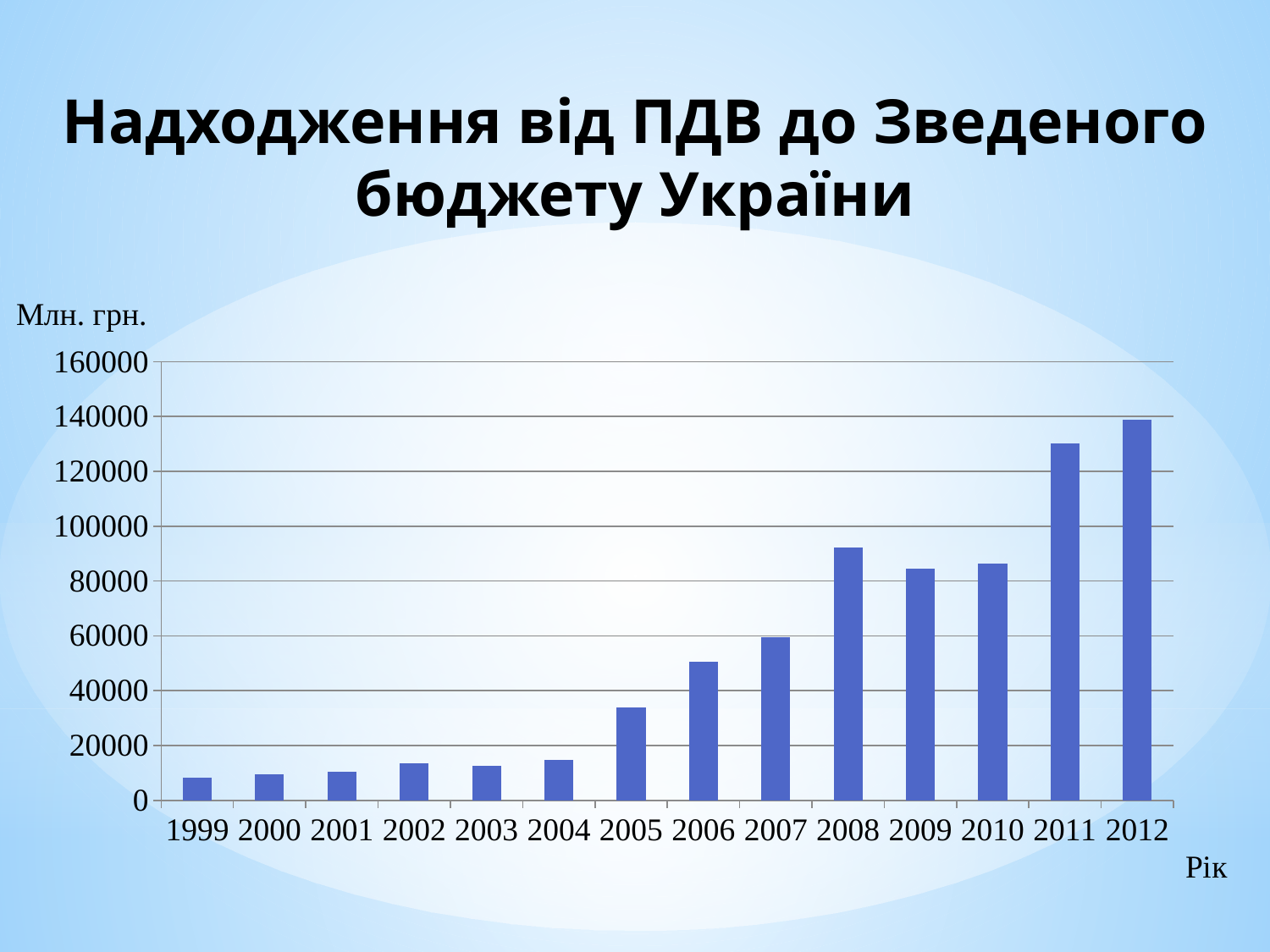
Which year has the larger value, 2011 or 2012? 2012 How many years are plotted on the x axis? 14 Do the values generally rise or fall from 1999 to 2012? Rise Which year has the larger value, 2008 or 2009? 2008 Which year has the highest VAT revenue? 2012 Is the value for 2004 greater or less than 20000? less What kind of chart is shown on the slide? Bar chart Which year has the lowest VAT revenue? 1999 What is the title of the chart? Надходження від ПДВ до Зведеного бюджету України Is the value for 2011 greater or less than 120000? greater Is the value for 2005 greater or less than 20000? greater What unit is shown on the vertical axis of the chart? Млн. грн.